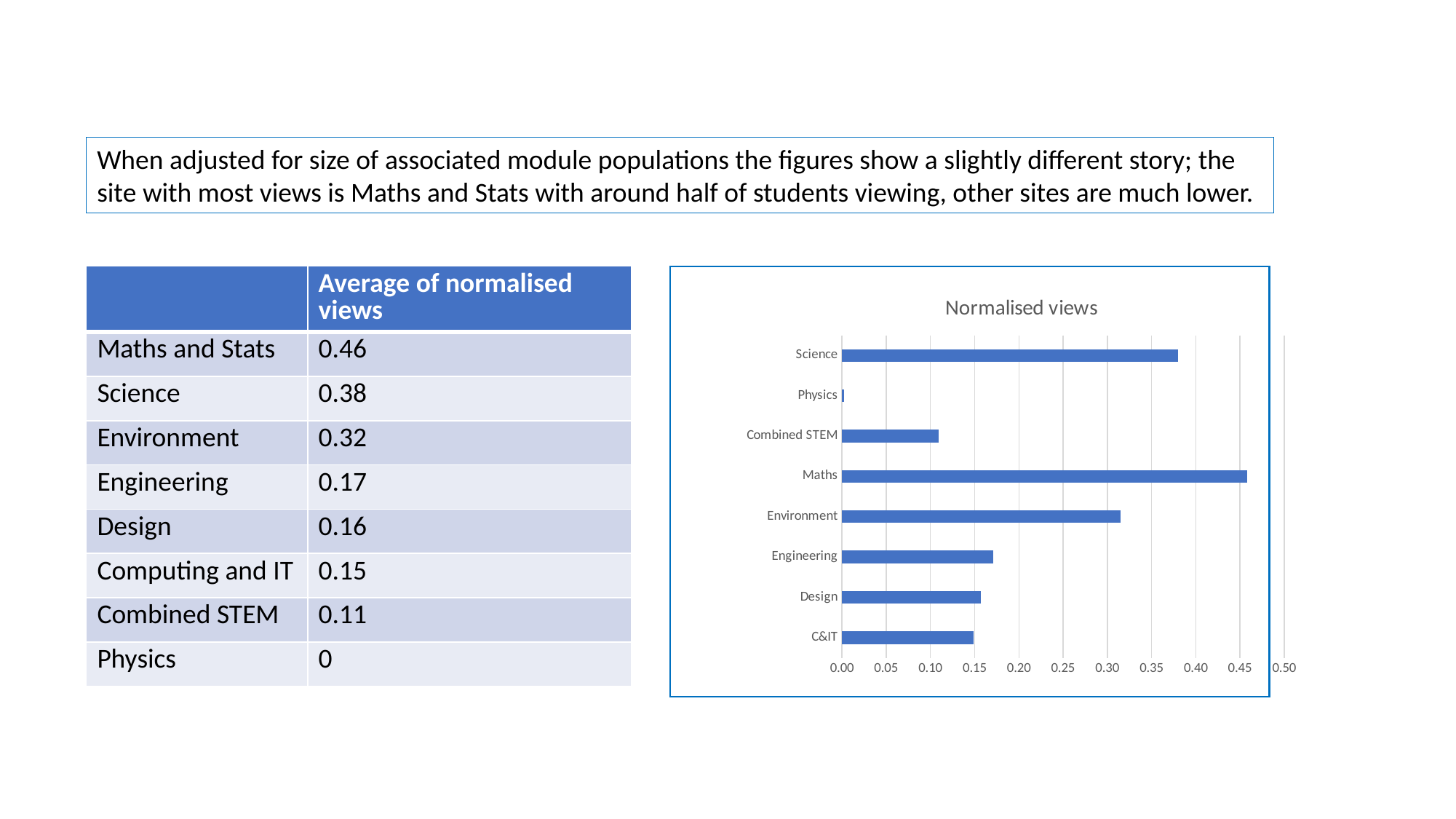
How many categories are plotted in the chart? 8 According to the slide, what is the normalised views value for Engineering? 0.17 Is the value for Combined STEM greater or less than 0.15? less Which category has the lowest value in the chart? Physics Is the value for Maths greater or less than 0.40? greater Which category has the highest value in the chart? Maths Is the value for Environment greater or less than 0.30? greater Which is larger, the value for Combined STEM or the value for Engineering? Engineering Which is larger, the value for Science or the value for Environment? Science According to the slide, what is the normalised views value for Science? 0.38 What is the title of the chart? Normalised views What kind of chart is shown on the slide? bar chart